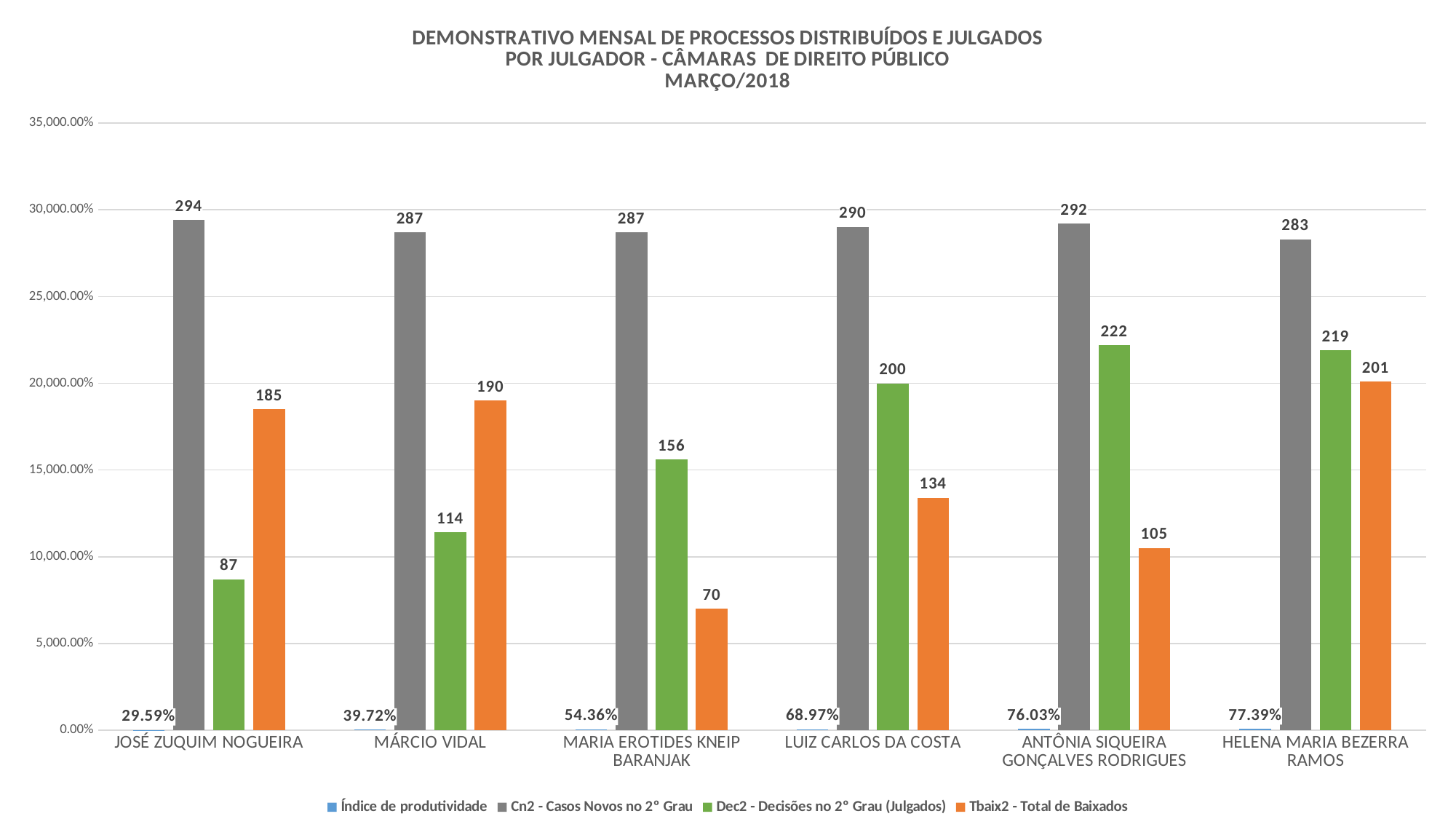
How many judges are shown on the x axis? 6 Which judge has the highest Dec2 - Decisões no 2° Grau (Julgados) value? ANTÔNIA SIQUEIRA GONÇALVES RODRIGUES What is the Dec2 - Decisões no 2° Grau (Julgados) value for LUIZ CARLOS DA COSTA? 200 What is the Índice de produtividade for HELENA MARIA BEZERRA RAMOS? 77.39% Does the Índice de produtividade rise or fall from left to right across the judges? Rise What is the Tbaix2 - Total de Baixados value for MARIA EROTIDES KNEIP BARANJAK? 70 Which judge has the lowest Índice de produtividade? JOSÉ ZUQUIM NOGUEIRA Which is larger: the Dec2 value for MÁRCIO VIDAL or the Dec2 value for MARIA EROTIDES KNEIP BARANJAK? MARIA EROTIDES KNEIP BARANJAK How many series does the legend list? 4 What is the difference between the Tbaix2 - Total de Baixados values for HELENA MARIA BEZERRA RAMOS and ANTÔNIA SIQUEIRA GONÇALVES RODRIGUES? 96 What is the Cn2 - Casos Novos no 2° Grau value for JOSÉ ZUQUIM NOGUEIRA? 294 What kind of chart is shown on the slide? Bar chart